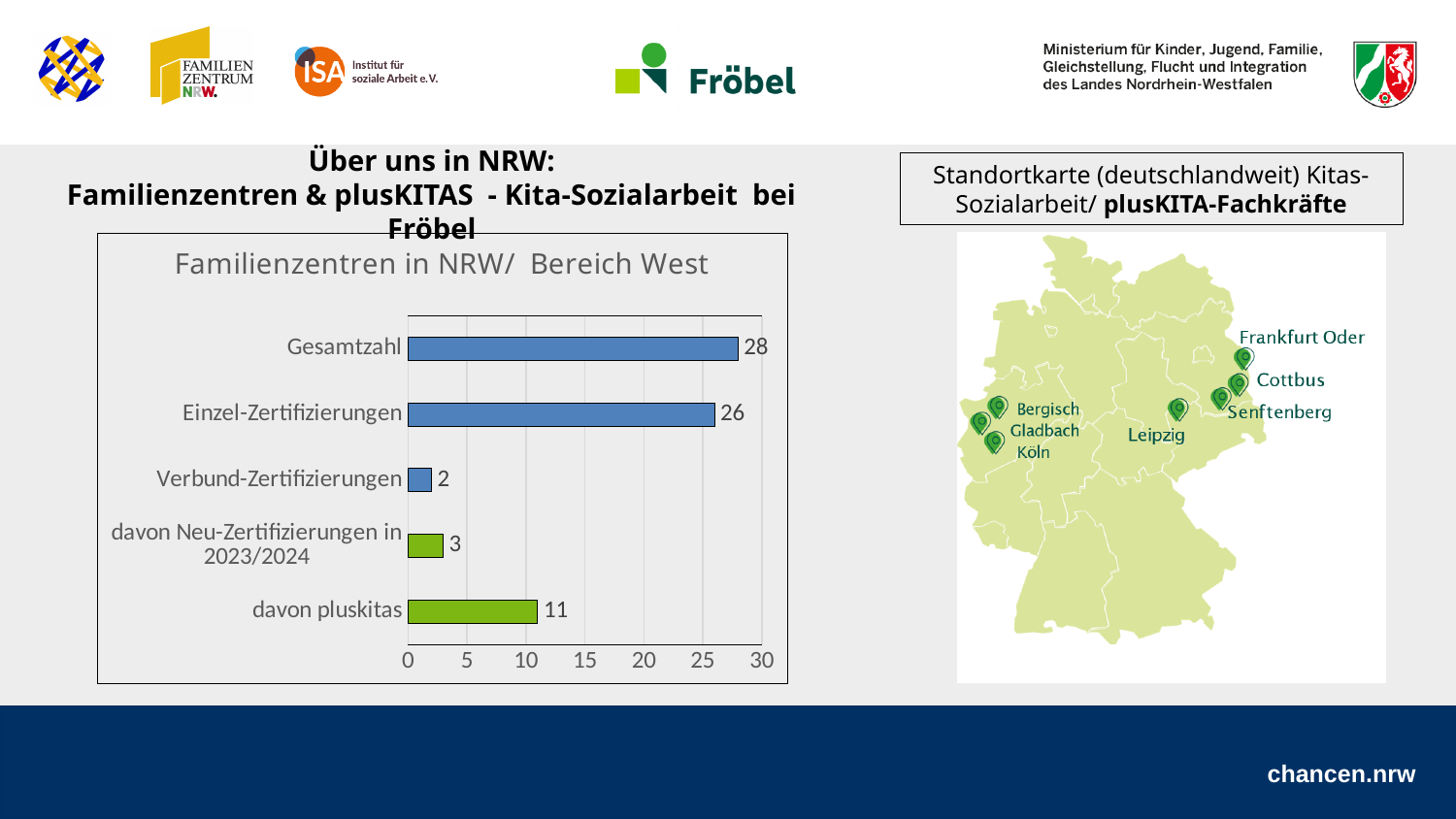
What is the value for Gesamtzahl in the chart 'Familienzentren in NRW/ Bereich West'? 28 Which is larger: 'davon pluskitas' or 'davon Neu-Zertifizierungen in 2023/2024'? davon pluskitas What is the value for Verbund-Zertifizierungen? 2 How many categories are shown in the chart? 5 What is the title of the chart? Familienzentren in NRW/ Bereich West What is the value for 'davon Neu-Zertifizierungen in 2023/2024'? 3 What is the value for 'davon pluskitas'? 11 Which category has the highest value in the chart? Gesamtzahl Which category has the lowest value in the chart? Verbund-Zertifizierungen What kind of chart is shown on the slide? Bar chart What is the value for Einzel-Zertifizierungen? 26 What is the difference between Gesamtzahl and Einzel-Zertifizierungen? 2